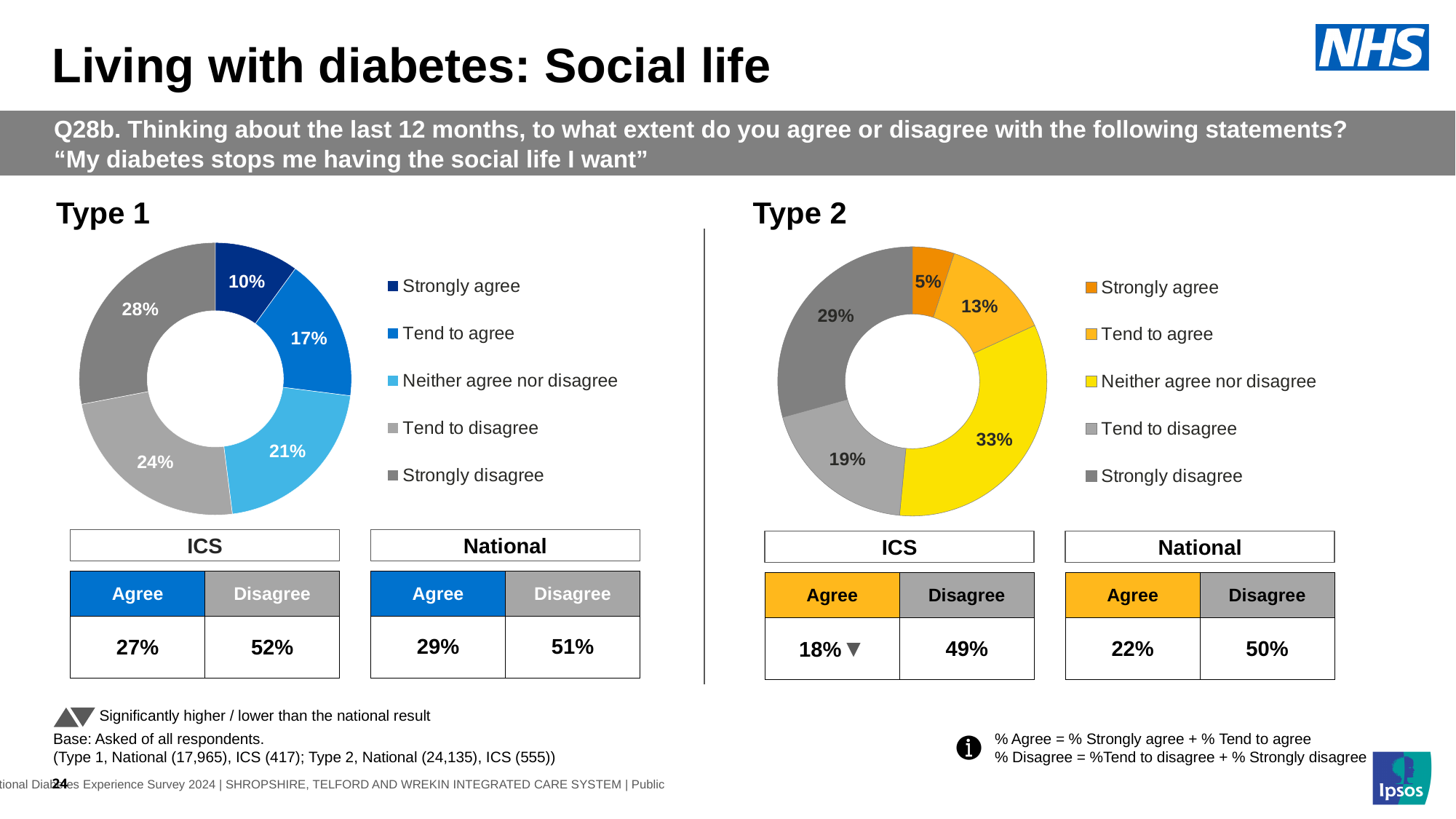
What colour is used for 'Neither agree nor disagree' in the Type 2 chart? Yellow In the Type 2 chart, what percentage of respondents said 'Neither agree nor disagree'? 33% In the Type 1 chart, what is the combined share of 'Strongly agree' and 'Tend to agree'? 27% In the Type 1 chart, what share of the pie is 'Neither agree nor disagree'? 21% In the Type 1 chart, what percentage of respondents said 'Strongly agree'? 10% In the Type 2 chart, what is the combined share of 'Tend to disagree' and 'Strongly disagree'? 48% What kind of chart is used for Type 2? Doughnut (pie) chart In the Type 1 chart, what is the difference between the 'Tend to disagree' and 'Tend to agree' shares? 7 percentage points In the Type 2 chart, which response category has the smallest share? Strongly agree How many response categories does the Type 1 chart show? 5 In the Type 2 chart, which is larger: 'Tend to agree' or 'Tend to disagree'? Tend to disagree In the Type 1 chart, which response category has the largest share? Strongly disagree